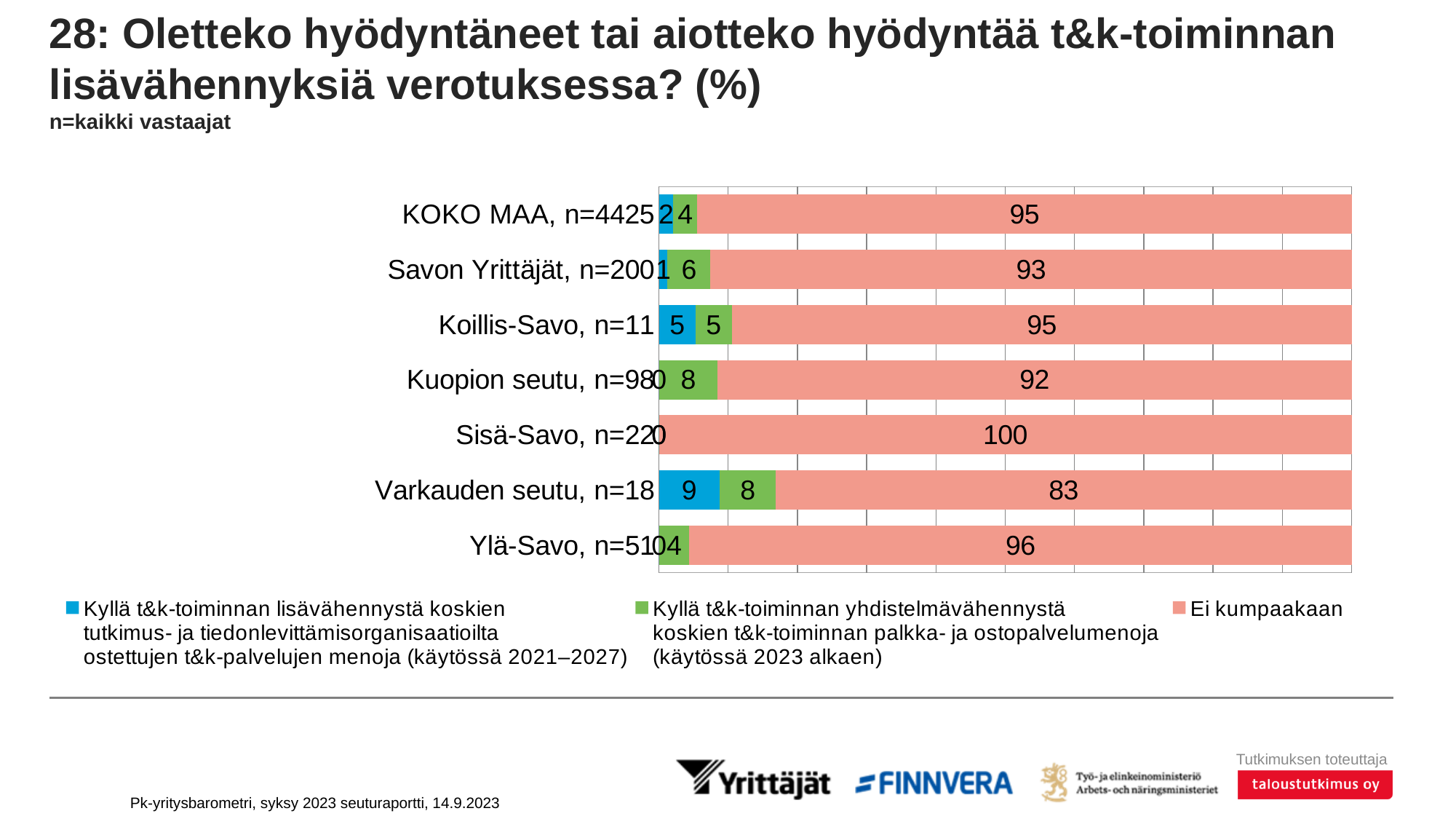
What is the difference between the blue series values for Varkauden seutu and Koillis-Savo? 4 What is the value of "Ei kumpaakaan" for Varkauden seutu? 83 What kind of chart is shown on the slide? Stacked bar chart What is the value of the blue series (lisävähennys) for Varkauden seutu? 9 How many series does the legend list? 3 Which category has the highest value for the blue series (lisävähennys)? Varkauden seutu What is the value of "Ei kumpaakaan" for Savon Yrittäjät? 93 Which has a larger green series value, Kuopion seutu or Savon Yrittäjät? Kuopion seutu What is the value of the green series (yhdistelmävähennys) for KOKO MAA? 4 Which category has the lowest value for "Ei kumpaakaan"? Varkauden seutu How many categories are shown in the chart? 7 Which category has the highest value for "Ei kumpaakaan"? Sisä-Savo